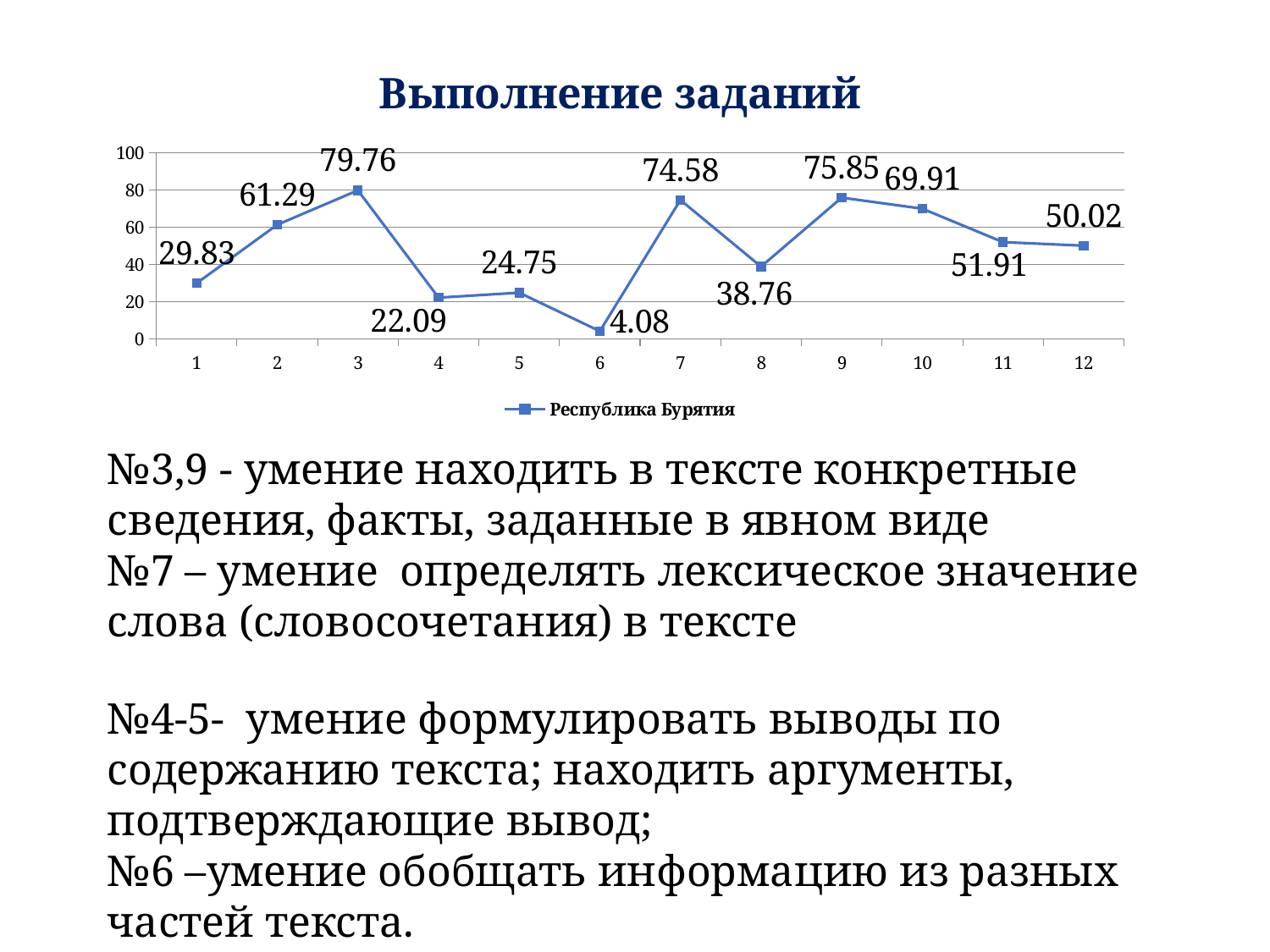
What is the name of the series in the legend? Республика Бурятия What is the value for task 3? 79.76 What is the difference between the values for task 3 and task 6? 75.68 Which is larger, the value for task 9 or the value for task 7? task 9 What is the value for task 6? 4.08 Which task has the lowest value? 6 Which task has the highest value? 3 How many series does the legend list? 1 What is the value for task 12? 50.02 Is the value for task 2 greater or less than 60? greater What kind of chart is shown? line chart How many tasks are plotted on the x axis? 12